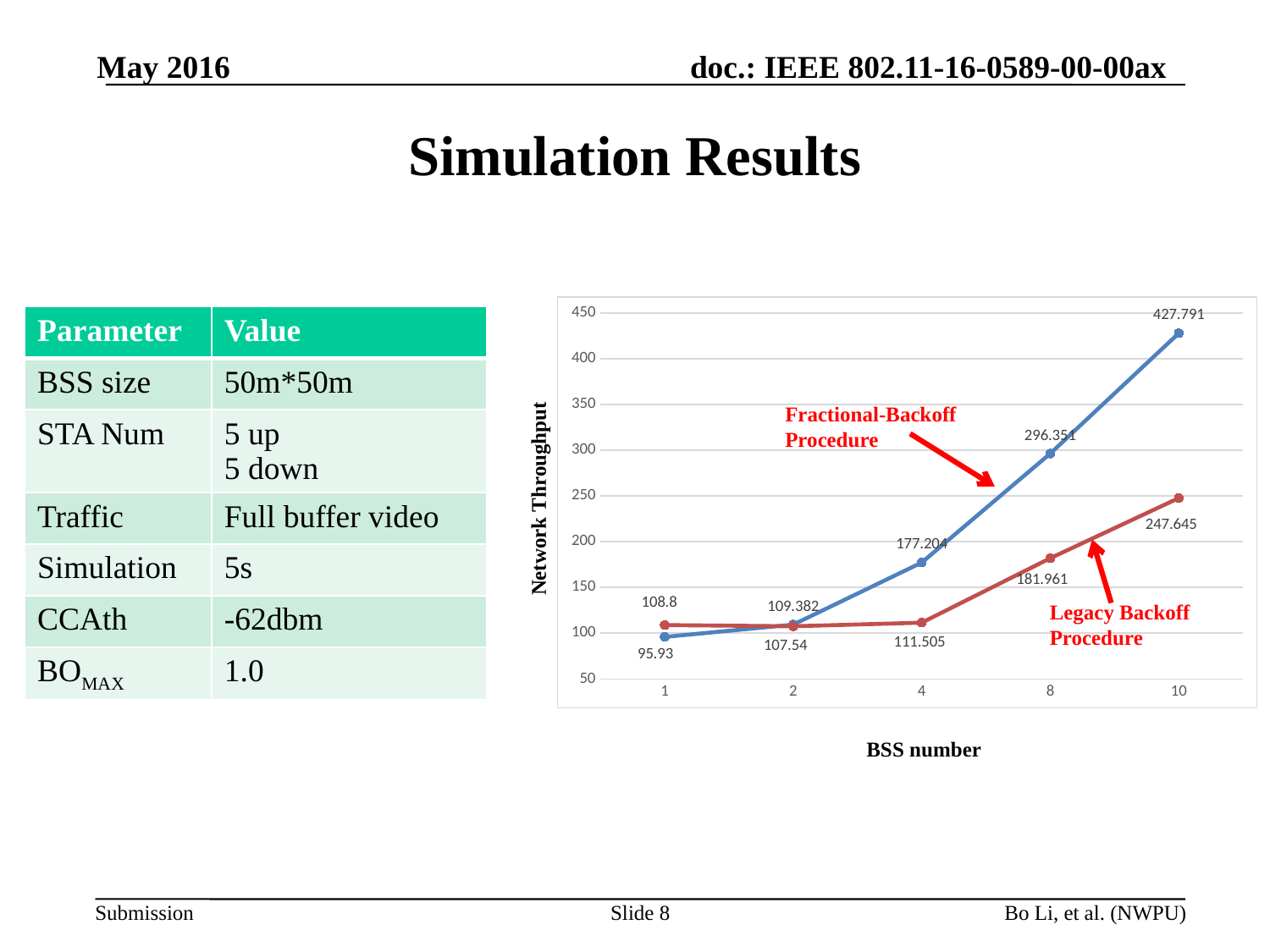
What is the Network Throughput of the Legacy Backoff Procedure at BSS number 4? 111.505 What type of chart is shown on the slide? Line chart What is the Network Throughput of the Fractional-Backoff Procedure at BSS number 8? 296.351 What is the Network Throughput of the Legacy Backoff Procedure at BSS number 10? 247.645 Does the Network Throughput of the Fractional-Backoff Procedure rise or fall as the BSS number increases? Rise How many BSS number values are plotted on the x axis? 5 What is the Network Throughput of the Fractional-Backoff Procedure at BSS number 1? 95.93 What is the Network Throughput of the Fractional-Backoff Procedure at BSS number 10? 427.791 At BSS number 8, which procedure has the higher Network Throughput? Fractional-Backoff Procedure At which BSS number is the Fractional-Backoff Procedure's Network Throughput lowest? 1 At which BSS number does the Fractional-Backoff Procedure reach its highest Network Throughput? 10 What is the difference in Network Throughput between the Fractional-Backoff Procedure and the Legacy Backoff Procedure at BSS number 10? 180.146